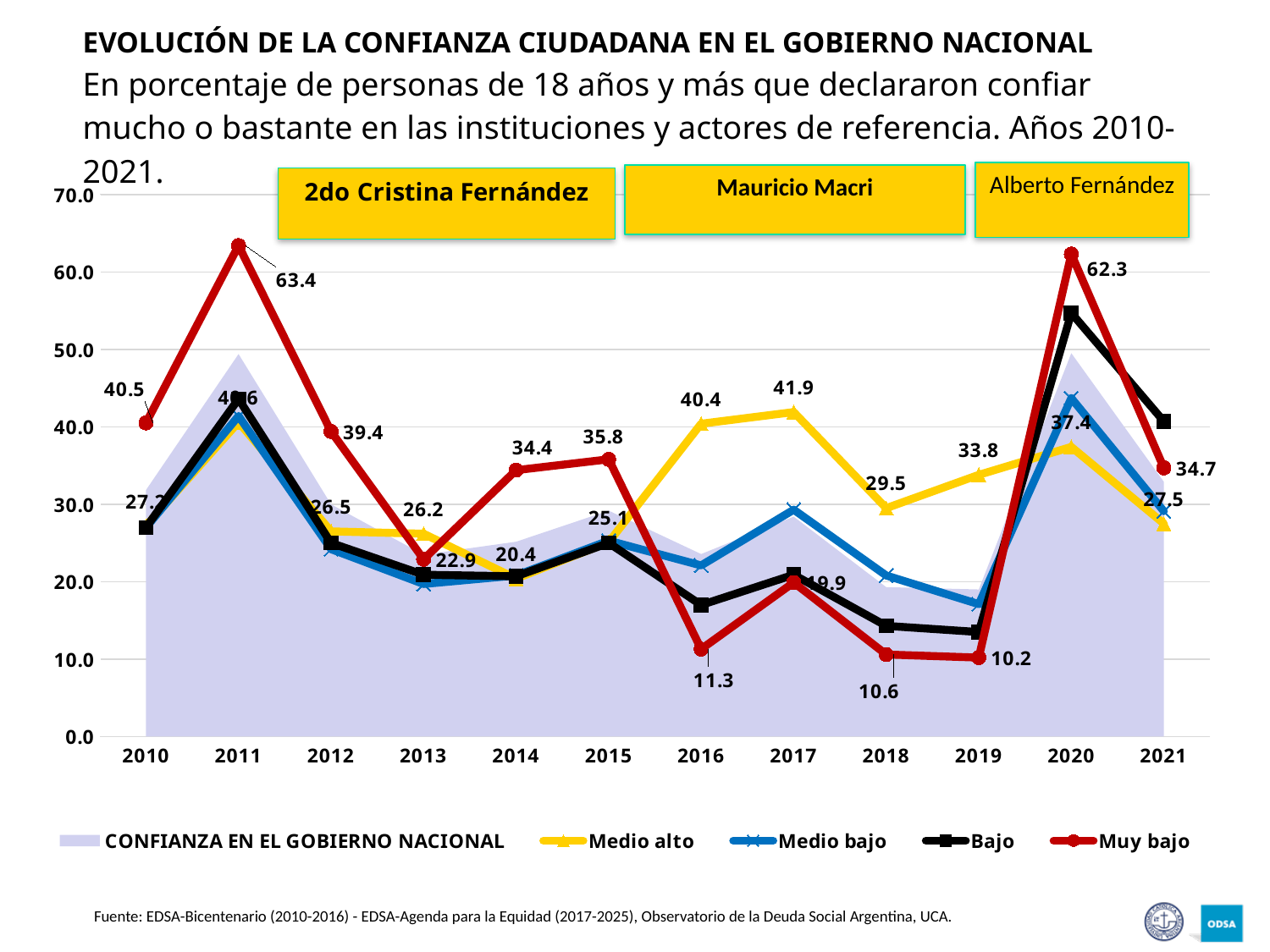
What kind of chart is shown on the slide? combination area and line chart What is the difference between the Medio alto value (40.4) and the Muy bajo value (11.3) in 2016? 29.1 What is the value of the Muy bajo series in 2011? 63.4 In which year does the Muy bajo series reach its highest value? 2011 What is the value of the Medio alto series in 2017? 41.9 How many series does the legend list? 5 Does the Muy bajo series rise or fall from 2011 to 2013? fall What is the value of the Muy bajo series in 2020? 62.3 Is the value of the Bajo series in 2020 greater or less than 50? greater How many years are shown on the x axis? 12 What is the value of the Muy bajo series in 2019? 10.2 In which year does the Muy bajo series reach its lowest value? 2019